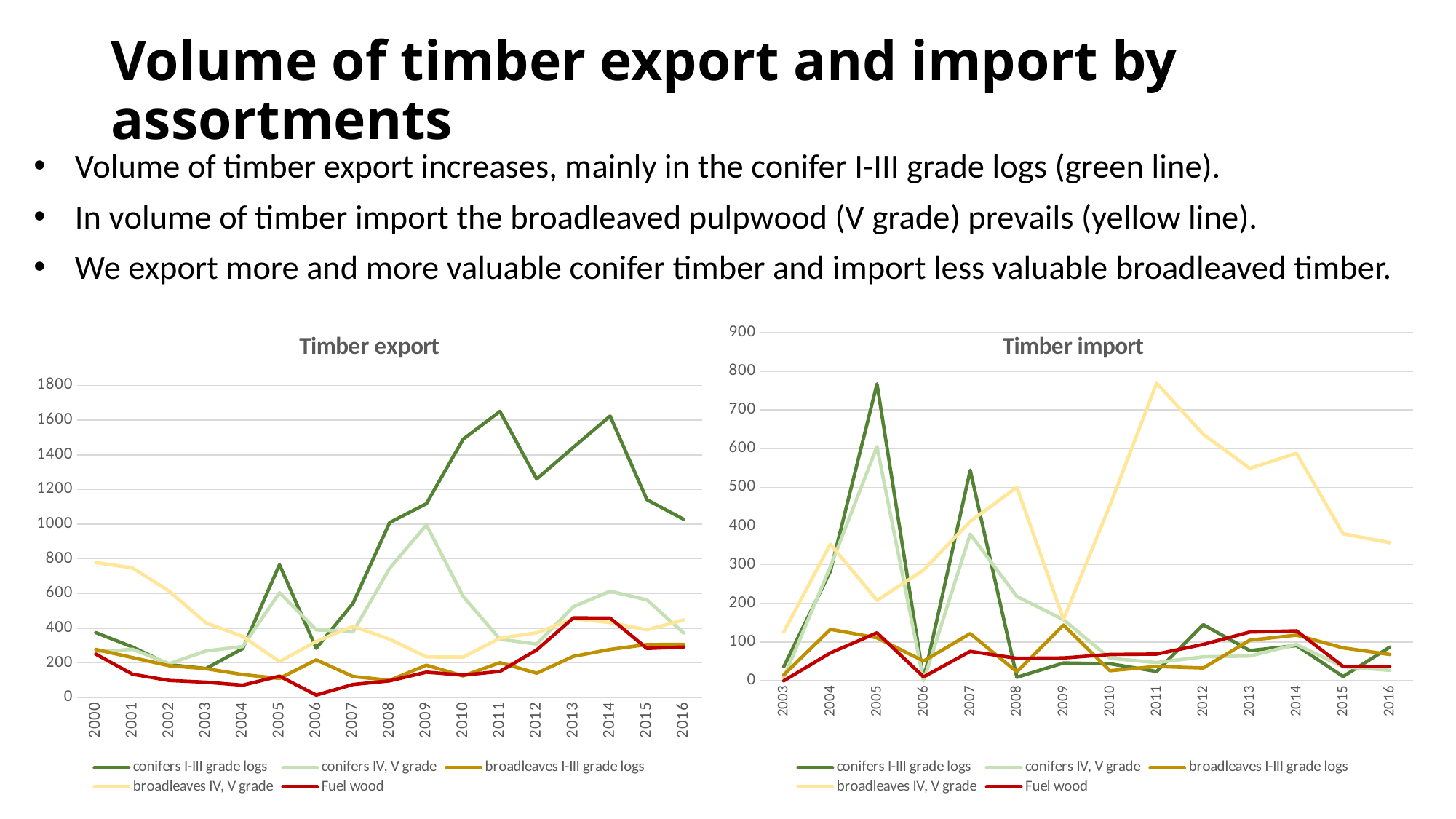
In the Timber import chart, is the value for Fuel wood in 2006 greater or less than 100? less How many series does the legend of the Timber import chart list? 5 In the Timber export chart, in which year does the conifers I-III grade logs line reach its highest value? 2011 What type of chart is the Timber export chart? line chart In the Timber import chart, does the broadleaves IV, V grade line rise or fall from 2011 to 2016? fall In the Timber export chart, which is larger in 2016: conifers I-III grade logs or broadleaves IV, V grade? conifers I-III grade logs How many years are shown on the x axis of the Timber export chart? 17 How many years are shown on the x axis of the Timber import chart? 14 In the Timber import chart, in which year does the conifers I-III grade logs line reach its highest value? 2005 In the Timber export chart, is the value for conifers I-III grade logs in 2011 greater or less than 1400? greater In the Timber import chart, in which year does the broadleaves IV, V grade line reach its highest value? 2011 In the Timber export chart, is the value for broadleaves IV, V grade in 2000 greater or less than 600? greater